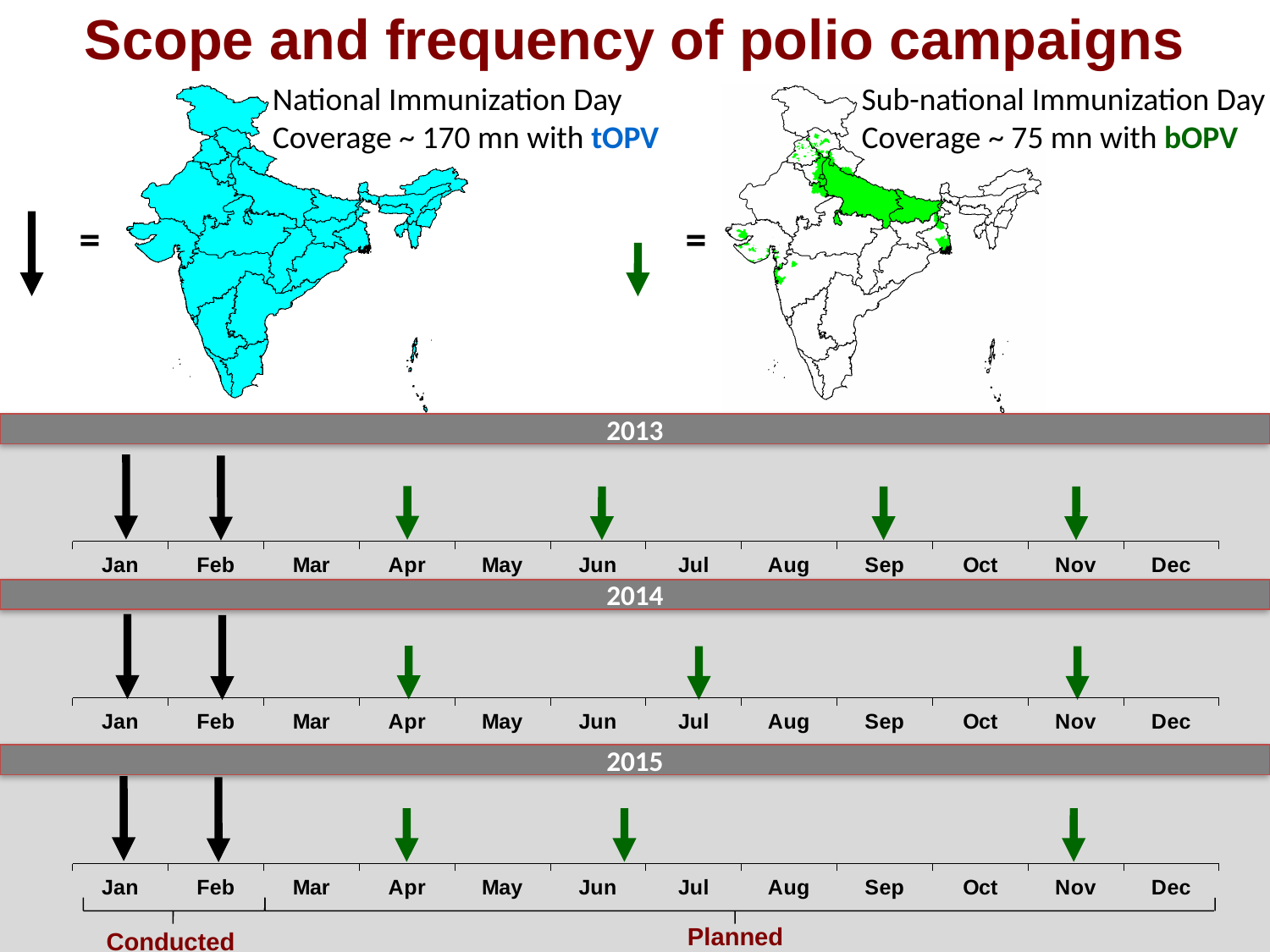
What coverage is stated for the Sub-national Immunization Day? ~ 75 mn In which months are the Sub-national Immunization Day (green arrow) campaigns shown for 2015? Apr, Jun, Nov How many campaign arrows are shown on the 2013 timeline? 6 How many years are shown on the timeline? 3 How many campaign arrows are shown on the 2015 timeline? 5 What kind of chart is shown in the lower part of the slide? timeline Which year on the timeline has the most campaign arrows? 2013 Which vaccine is used for the National Immunization Day campaigns? tOPV In which months are the Sub-national Immunization Day (green arrow) campaigns shown for 2013? Apr, Jun, Sep, Nov In which months are the National Immunization Day (black arrow) campaigns held in 2014? Jan and Feb